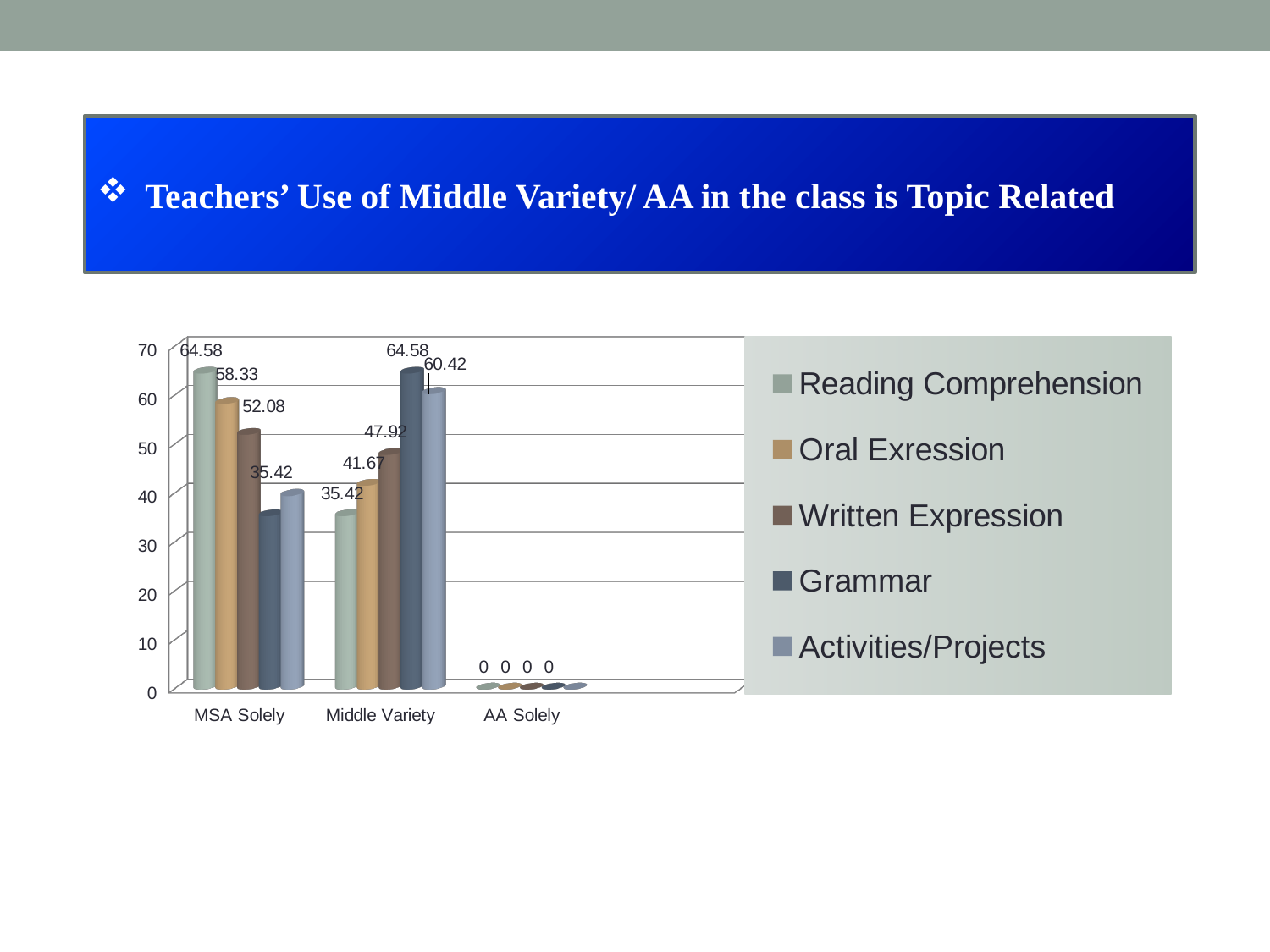
What is the difference between the Oral Exression values for MSA Solely and Middle Variety? 16.66 Which series has the lowest value in the MSA Solely category? Grammar What is the value for Oral Exression in the Middle Variety category? 41.67 How many categories are shown on the x axis? 3 Is the Written Expression value larger for MSA Solely or for Middle Variety? MSA Solely How many series does the legend list? 5 Is the value for Activities/Projects in the MSA Solely category greater or less than 50? less What kind of chart is shown on the slide? bar chart What is the value for Grammar in the Middle Variety category? 64.58 What is the value for Reading Comprehension in the MSA Solely category? 64.58 Which series has the highest value in the Middle Variety category? Grammar What is the value for Written Expression in the MSA Solely category? 52.08